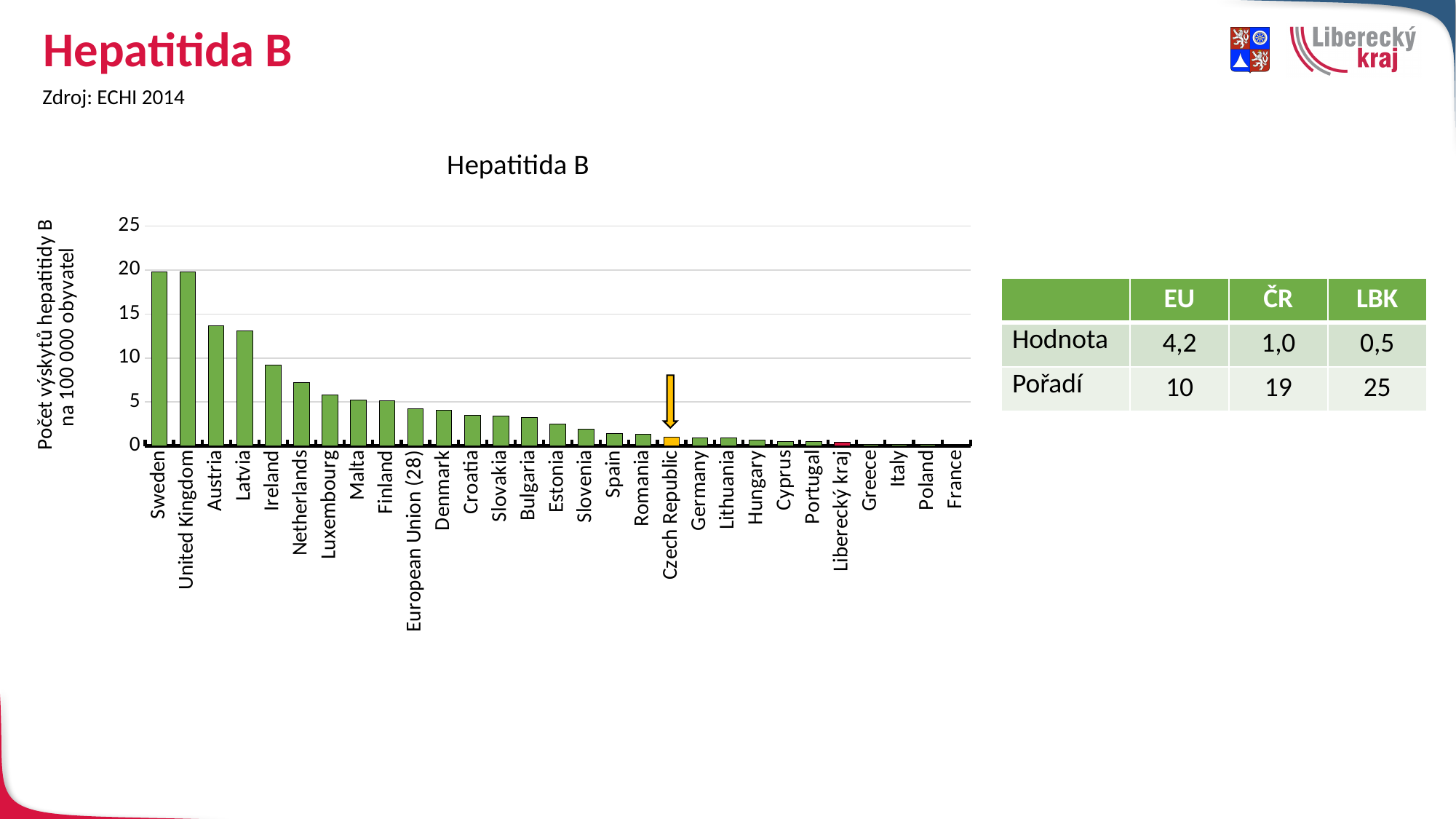
What is the title of the chart? Hepatitida B Is the value for Austria greater or less than 15? less Is the value for Ireland greater or less than 10? less Do the values rise or fall moving from left to right along the x axis? fall Is the value for Sweden greater or less than 15? greater What colour is the bar for Czech Republic, which the arrow points to? orange What kind of chart is shown on the slide? bar chart Which has the larger value, Croatia or Spain? Croatia Which has the larger value, Ireland or Netherlands? Ireland How many countries/regions are plotted on the x axis of the chart? 29